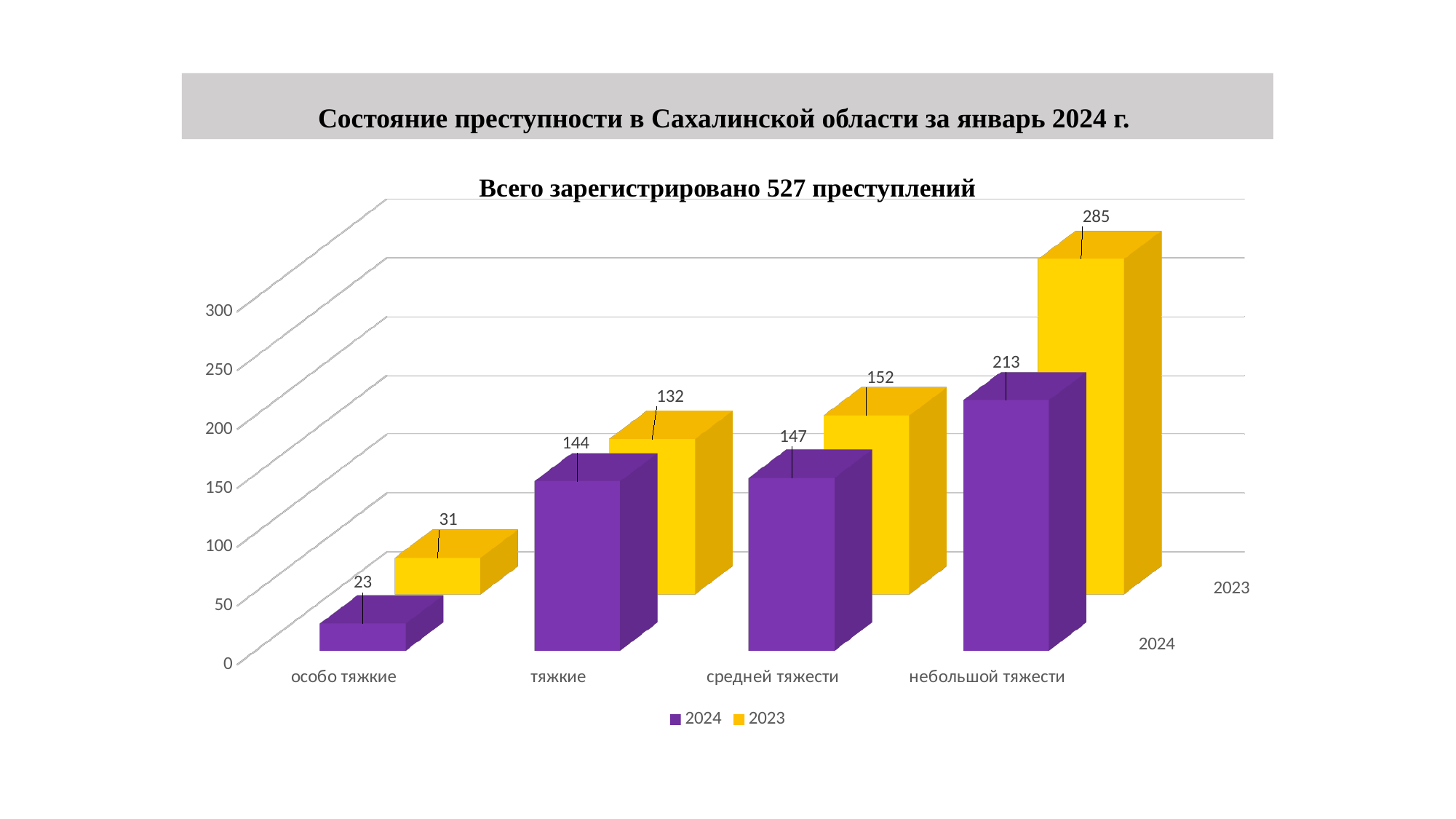
Which is larger for "тяжкие": the 2024 value or the 2023 value? 2024 What kind of chart is shown on the slide? bar chart What is the value for 2024 in the category "особо тяжкие"? 23 What is the value for 2023 in the category "тяжкие"? 132 How many categories are shown on the x axis? 4 How many series does the legend list? 2 What is the value for 2023 in the category "небольшой тяжести"? 285 What is the difference between the 2023 and 2024 values for "небольшой тяжести"? 72 Which category has the highest value for the 2023 series? небольшой тяжести What is the chart's title? Всего зарегистрировано 527 преступлений What is the value for 2024 in the category "средней тяжести"? 147 Which category has the lowest value for the 2024 series? особо тяжкие